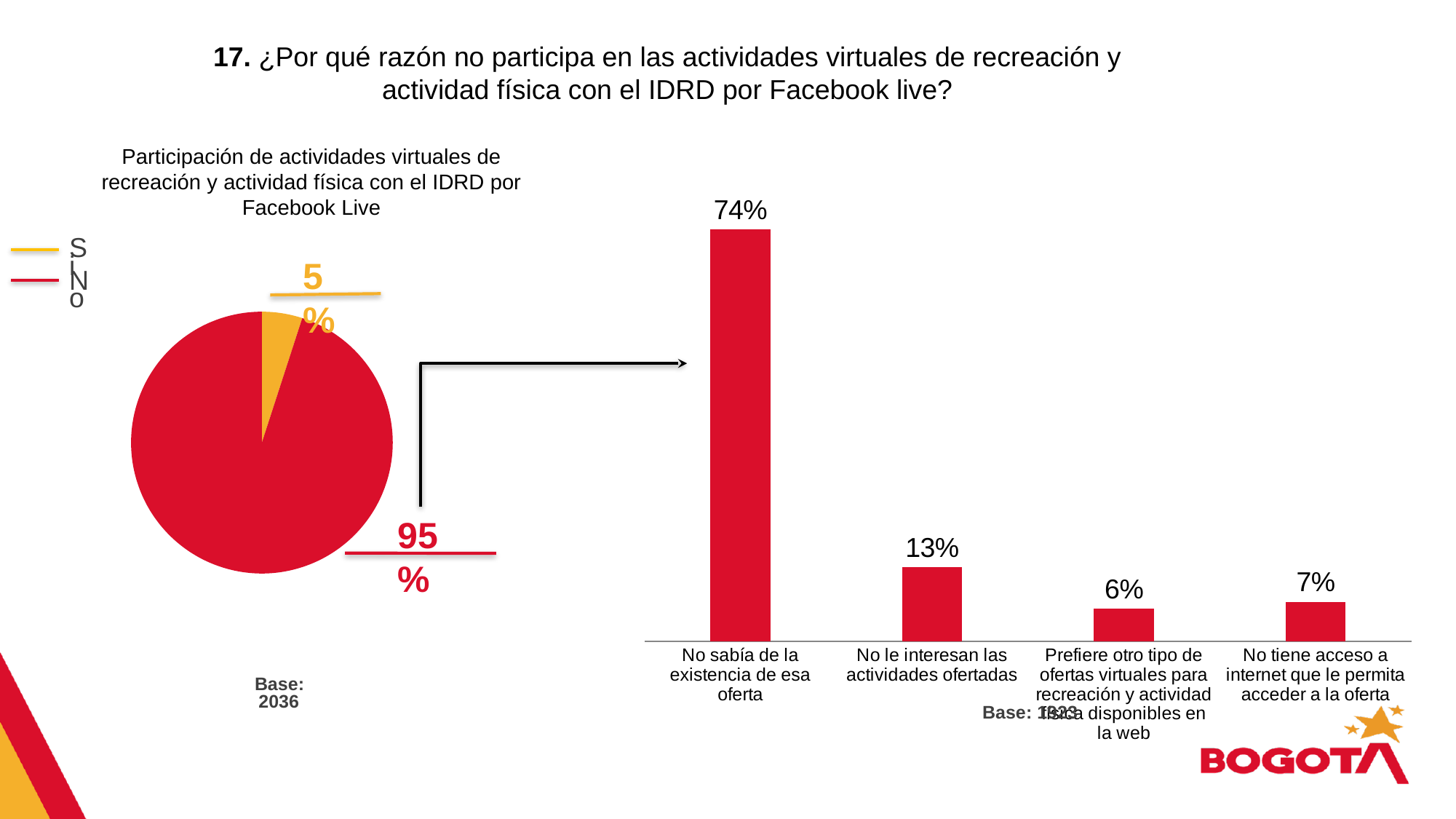
In the bar chart on the right, what is the value for "No tiene acceso a internet que le permita acceder a la oferta"? 7% In the bar chart on the right, what is the difference between the values for "No sabía de la existencia de esa oferta" and "No le interesan las actividades ofertadas"? 61% In the bar chart on the right, what is the value for "No sabía de la existencia de esa oferta"? 74% In the pie chart on the left, which response has the larger slice, "Sí" or "No"? No In the pie chart on the left, what share of respondents answered "No"? 95% In the bar chart on the right, what is the value for "No le interesan las actividades ofertadas"? 13% In the bar chart on the right, which category has the highest value? No sabía de la existencia de esa oferta In the bar chart on the right, how many categories are shown? 4 In the bar chart on the right, which category has the lowest value? Prefiere otro tipo de ofertas virtuales para recreación y actividad física disponibles en la web In the pie chart on the left, what share of respondents answered "Sí"? 5% What kind of chart is the chart on the left of the slide? Pie chart In the pie chart on the left, how many slices are there? 2